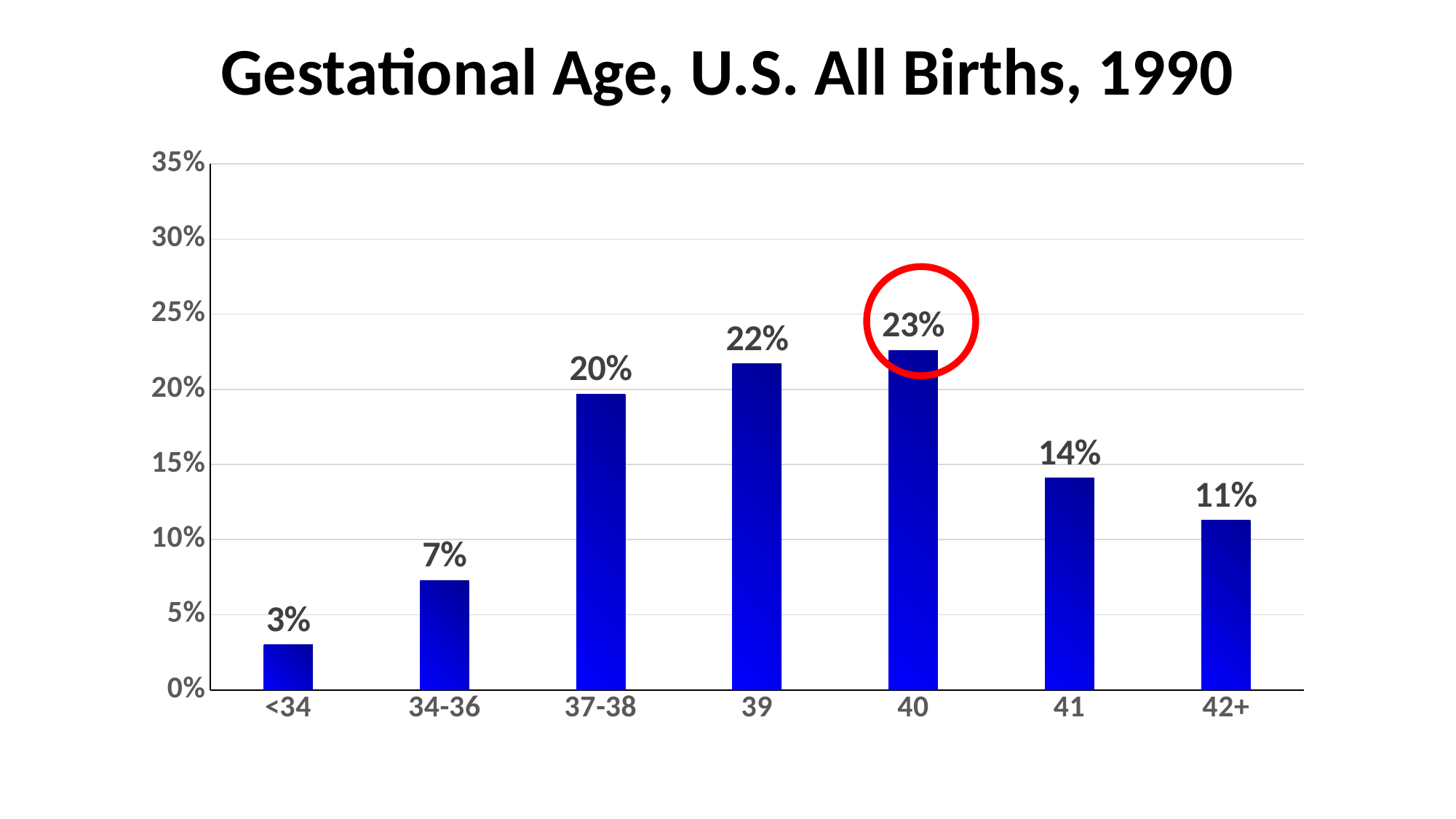
What kind of chart is shown? bar chart What is the value for the <34 category? 3% What is the value for the 42+ category? 11% How many categories are shown on the x axis? 7 Which category has the lowest value? <34 Is the value for 34-36 greater or less than 10%? less Which category's data label is circled in red? 40 What is the value for the 40 category? 23% Which is larger, the value for 37-38 or the value for 42+? 37-38 What is the title of the chart? Gestational Age, U.S. All Births, 1990 What is the difference between the values for 39 and 41? 8% Which category has the highest value? 40